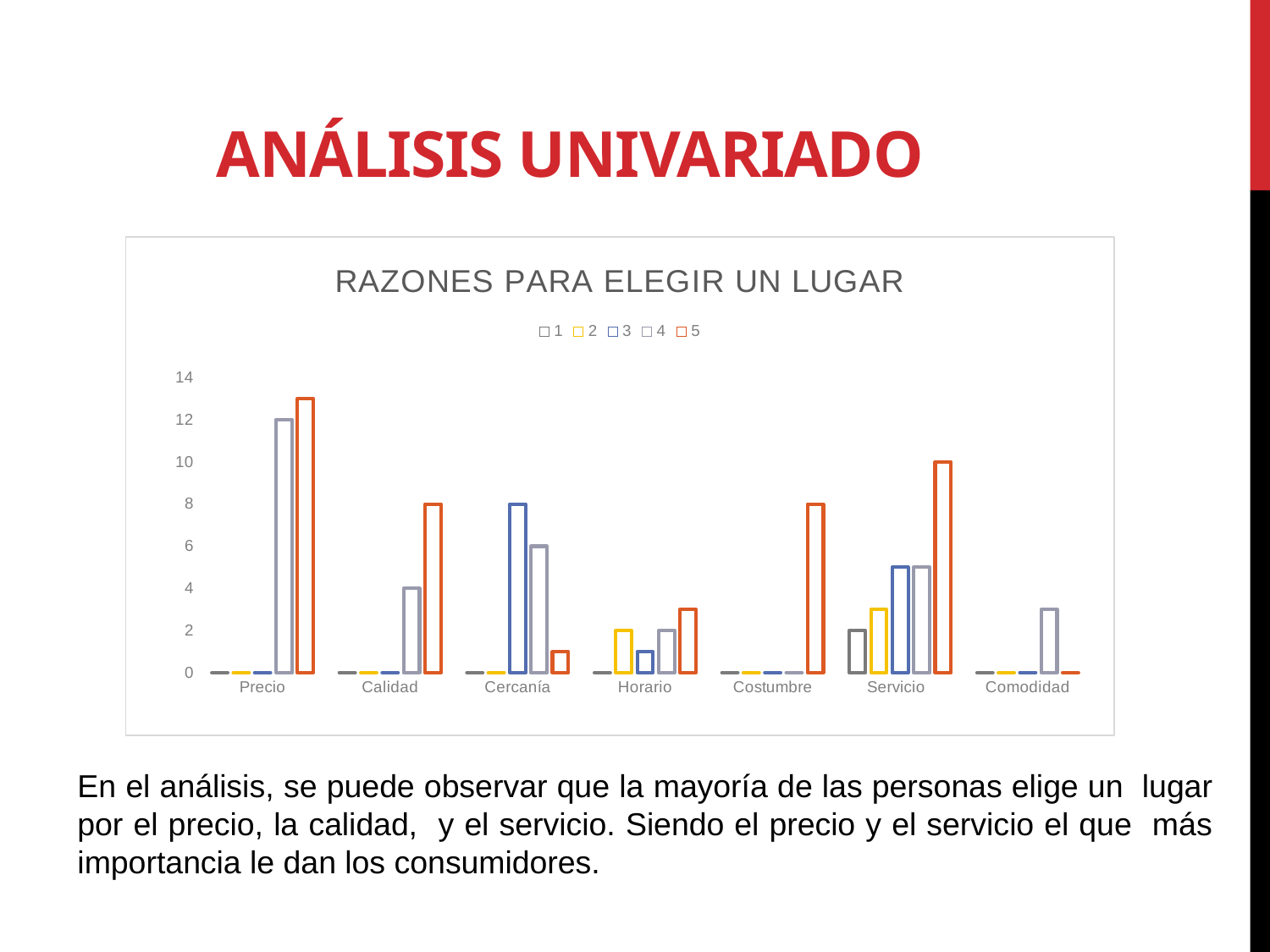
What is the value of series 5 for Servicio? 10 Is the value of series 5 for Precio greater or less than 12? greater How many categories are shown on the x axis? 7 What is the value of series 5 for Costumbre? 8 Which category has the highest value for series 5? Precio What kind of chart is shown on the slide? bar chart What is the difference between the series 5 values for Servicio and Costumbre? 2 How many series does the legend list? 5 What is the value of series 3 for Cercanía? 8 What is the title of the chart? RAZONES PARA ELEGIR UN LUGAR What is the value of series 4 for Precio? 12 Is the value of series 3 for Servicio greater or less than 4? greater